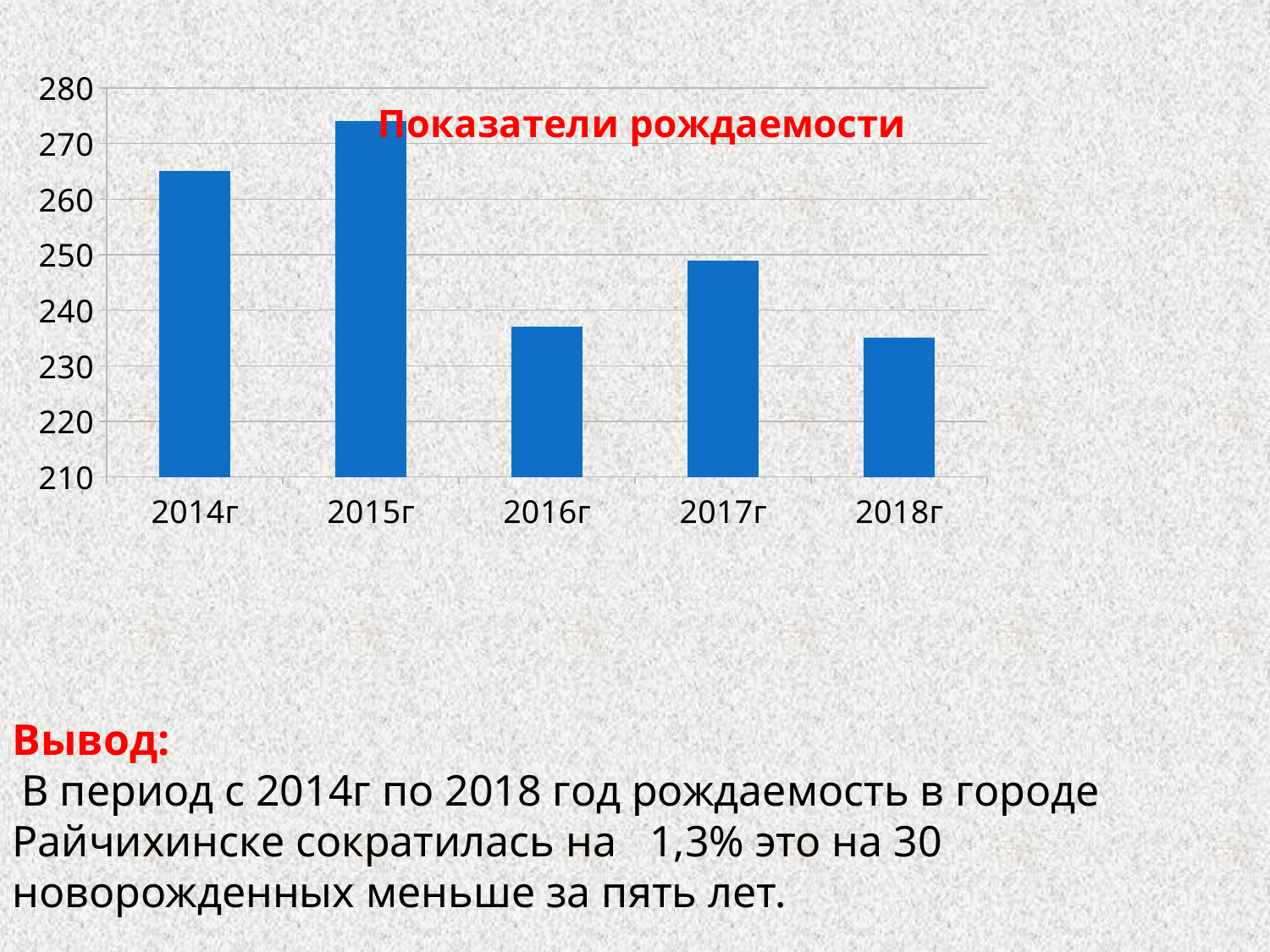
What is the title of the chart? Показатели рождаемости Which year has the highest bar in the chart? 2015г Which is larger, the value for 2015г or the value for 2016г? 2015г Overall, do the values rise or fall from 2014г to 2018г? fall What kind of chart is shown on the slide? bar chart Is the value for 2018г greater or less than 240? less Which is larger, the value for 2014г or the value for 2017г? 2014г Is the value for 2015г greater or less than 270? greater Is the value for 2017г greater or less than 240? greater How many years are shown on the x axis of the chart? 5